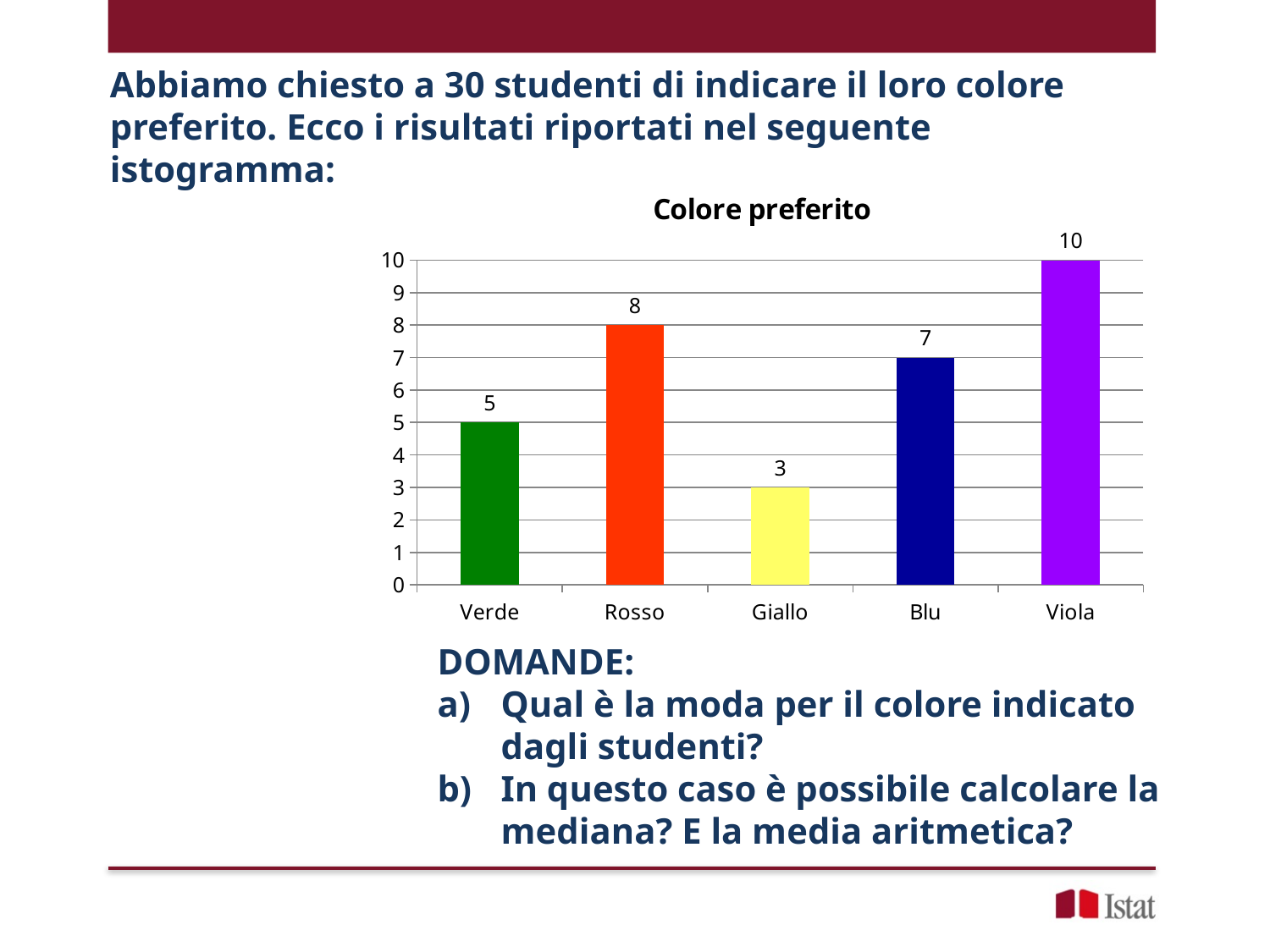
What is the value for Blu? 7 What kind of chart is shown on the slide? bar chart What is the difference between the values for Viola and Giallo? 7 What is the value for Rosso? 8 What is the value for Verde? 5 What is the difference between the values for Rosso and Verde? 3 What is the title of the chart? Colore preferito Which category has the highest value? Viola Which category has the lowest value? Giallo What is the value for Giallo? 3 How many categories are shown on the x axis? 5 Which is larger, the value for Rosso or the value for Blu? Rosso